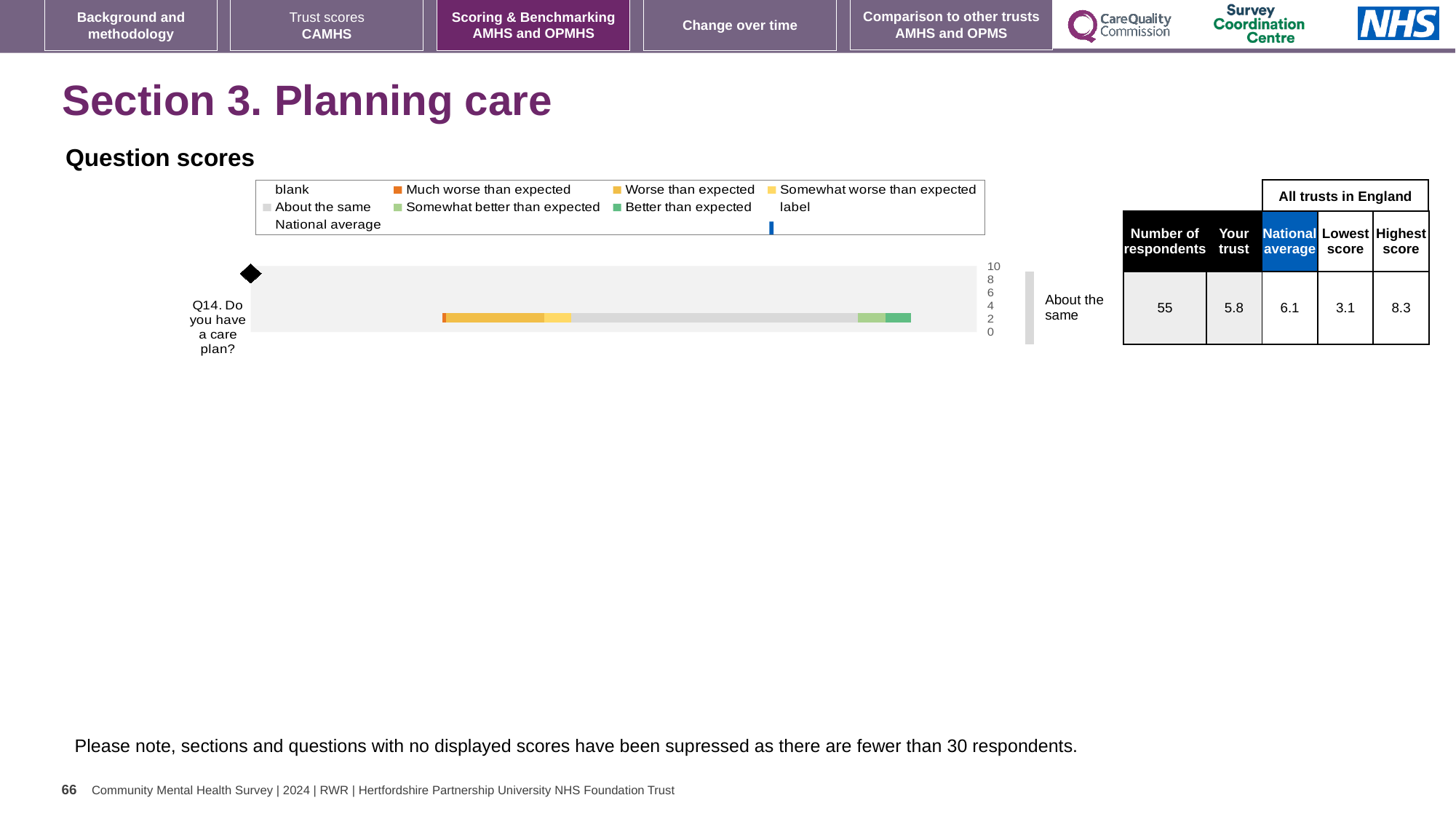
What colour does the legend use for 'Much worse than expected'? orange What benchmark category is shown for Q14 next to the chart? About the same What kind of chart is shown under 'Question scores'? bar chart What is the number of respondents for Q14? 55 What is the highest score among all trusts in England for Q14? 8.3 What is the lowest score among all trusts in England for Q14? 3.1 For Q14, which is larger: the 'Your trust' score or the national average? National average Which survey question is plotted in the chart? Q14. Do you have a care plan? What is the national average score for Q14? 6.1 What is the difference between the highest score and the lowest score for Q14? 5.2 How many survey questions are plotted in the chart? 1 What is the 'Your trust' score for Q14? 5.8